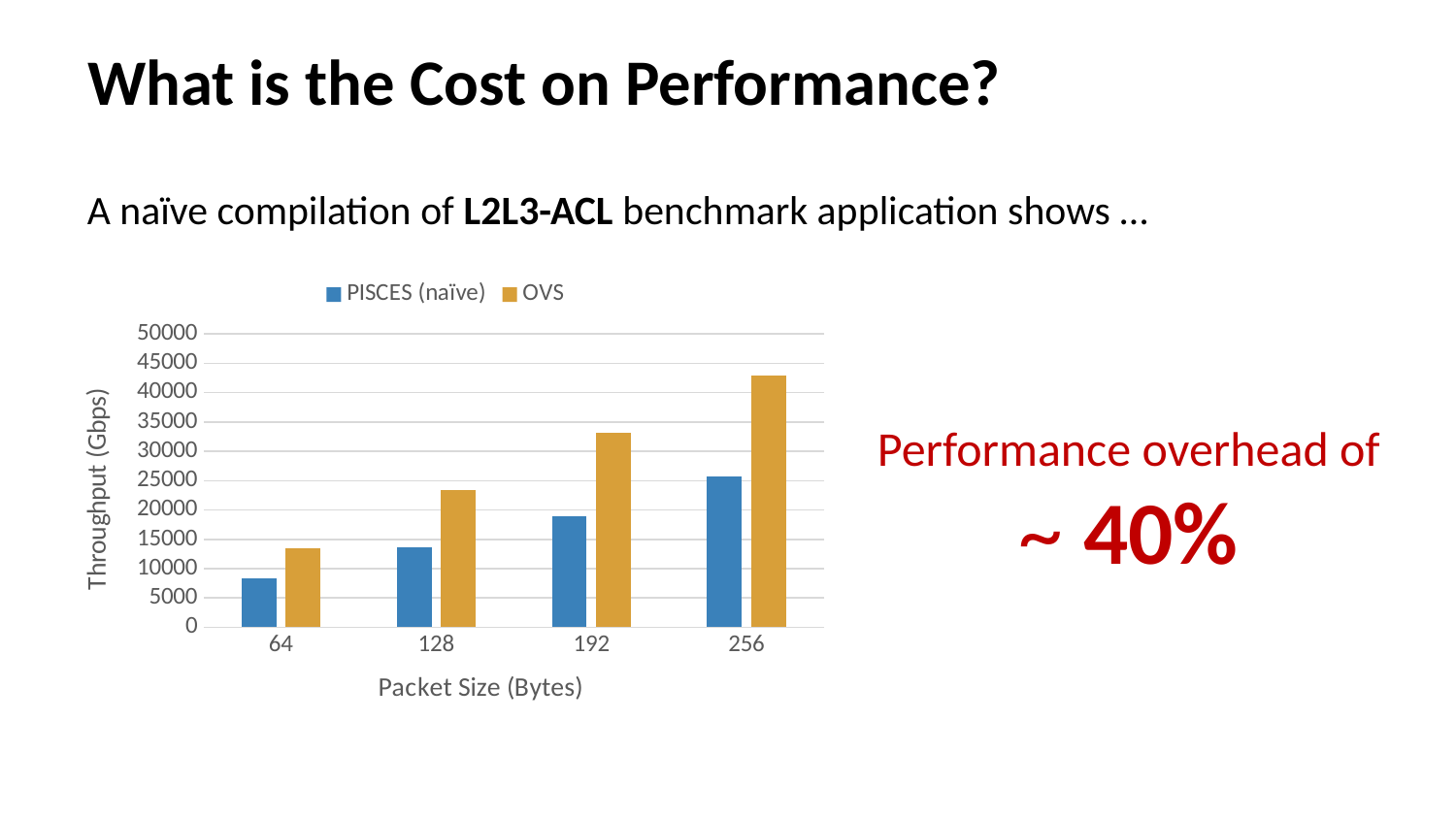
Is the PISCES (naïve) throughput at packet size 256 greater or less than 20000? greater Is the OVS throughput at packet size 256 greater or less than 40000? greater Is the PISCES (naïve) throughput at packet size 64 greater or less than 10000? less Do the OVS throughput values rise or fall as packet size increases along the x axis? rise How many series does the chart legend list? 2 Which series and packet size has the highest throughput in the chart? OVS at 256 How many packet sizes are shown on the x axis of the chart? 4 What kind of chart is shown on the slide? bar chart What is the label of the y axis of the chart? Throughput (Gbps) At packet size 256, which series has the higher throughput, PISCES (naïve) or OVS? OVS Which series and packet size has the lowest throughput in the chart? PISCES (naïve) at 64